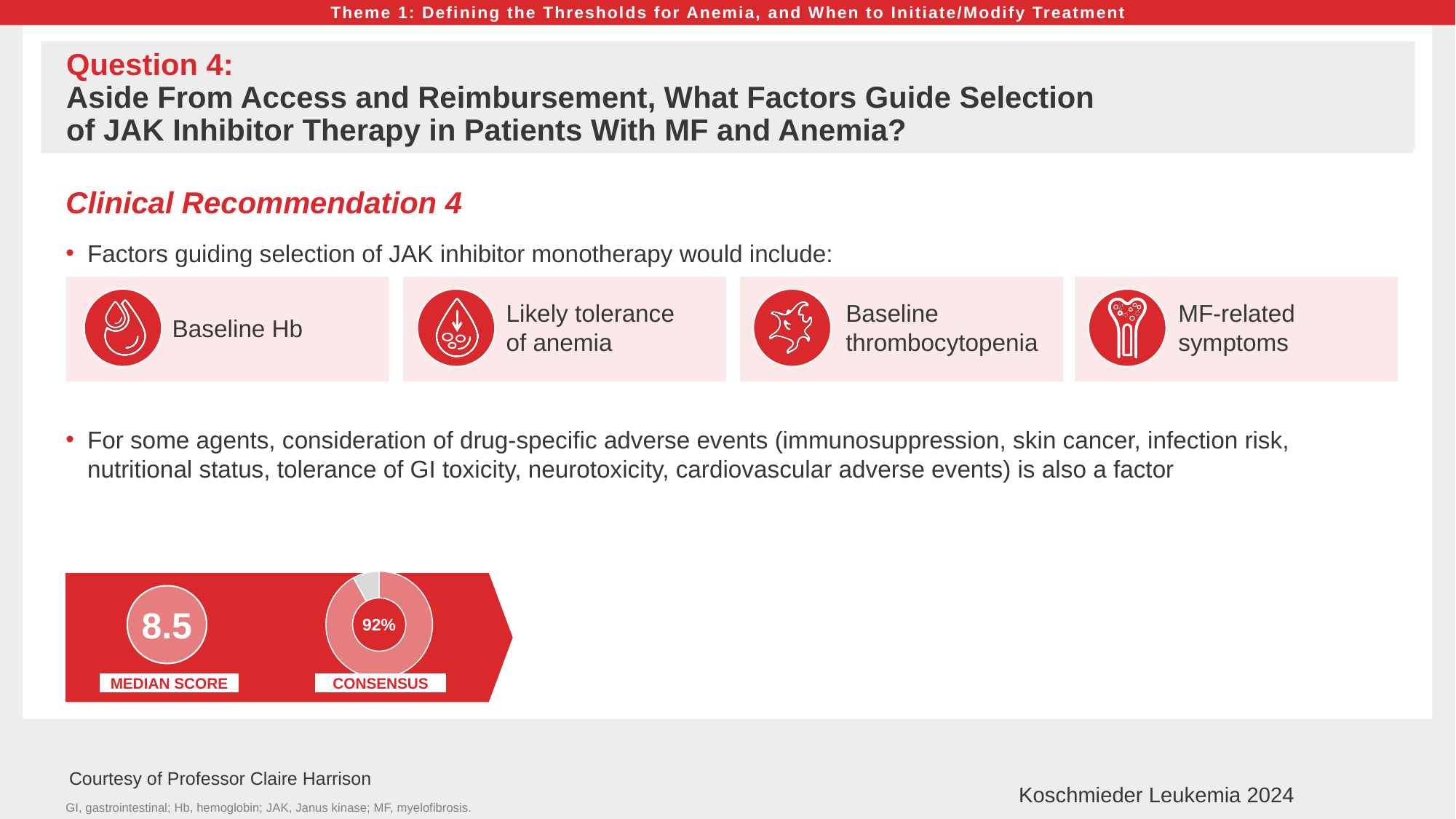
Is the consensus value shown in the doughnut chart greater or less than 90%? greater What label appears beneath the doughnut chart? CONSENSUS In the consensus doughnut chart, which slice is larger: the consensus slice or the remaining slice? The consensus slice What median score is displayed next to the consensus doughnut chart? 8.5 What kind of chart is used to show the consensus value on the slide? Doughnut (pie) chart What consensus percentage is shown in the centre of the doughnut chart? 92% What share of the doughnut chart is not covered by the 92% consensus slice? 8% How many slices does the consensus doughnut chart have? 2